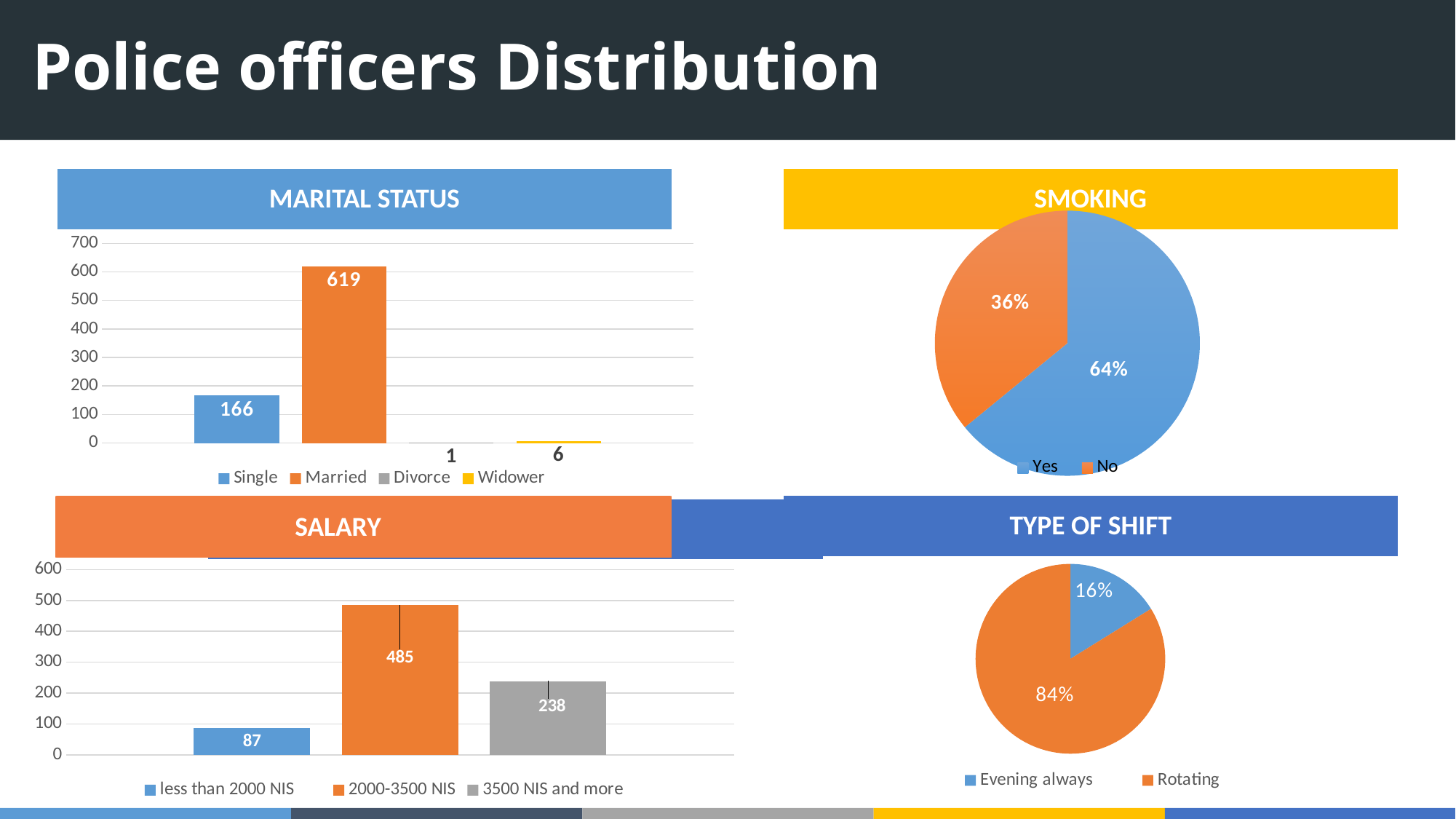
In the Marital Status chart, which category has the lowest value? Divorce In the Marital Status chart, how many categories are shown in the legend? 4 In the Marital Status chart, what is the value for Married? 619 In the Type of Shift chart, what share of the pie is Rotating? 84% What kind of chart is the Smoking chart? Pie chart In the Salary chart, what is the value for 3500 NIS and more? 238 In the Smoking chart, what share of the pie is Yes? 64% In the Marital Status chart, what is the difference between the Married and Single values? 453 In the Salary chart, what is the difference between the 2000-3500 NIS and less than 2000 NIS values? 398 What kind of chart is the Salary chart? Bar chart In the Salary chart, which category has the highest value? 2000-3500 NIS In the Smoking chart, which is larger, Yes or No? Yes